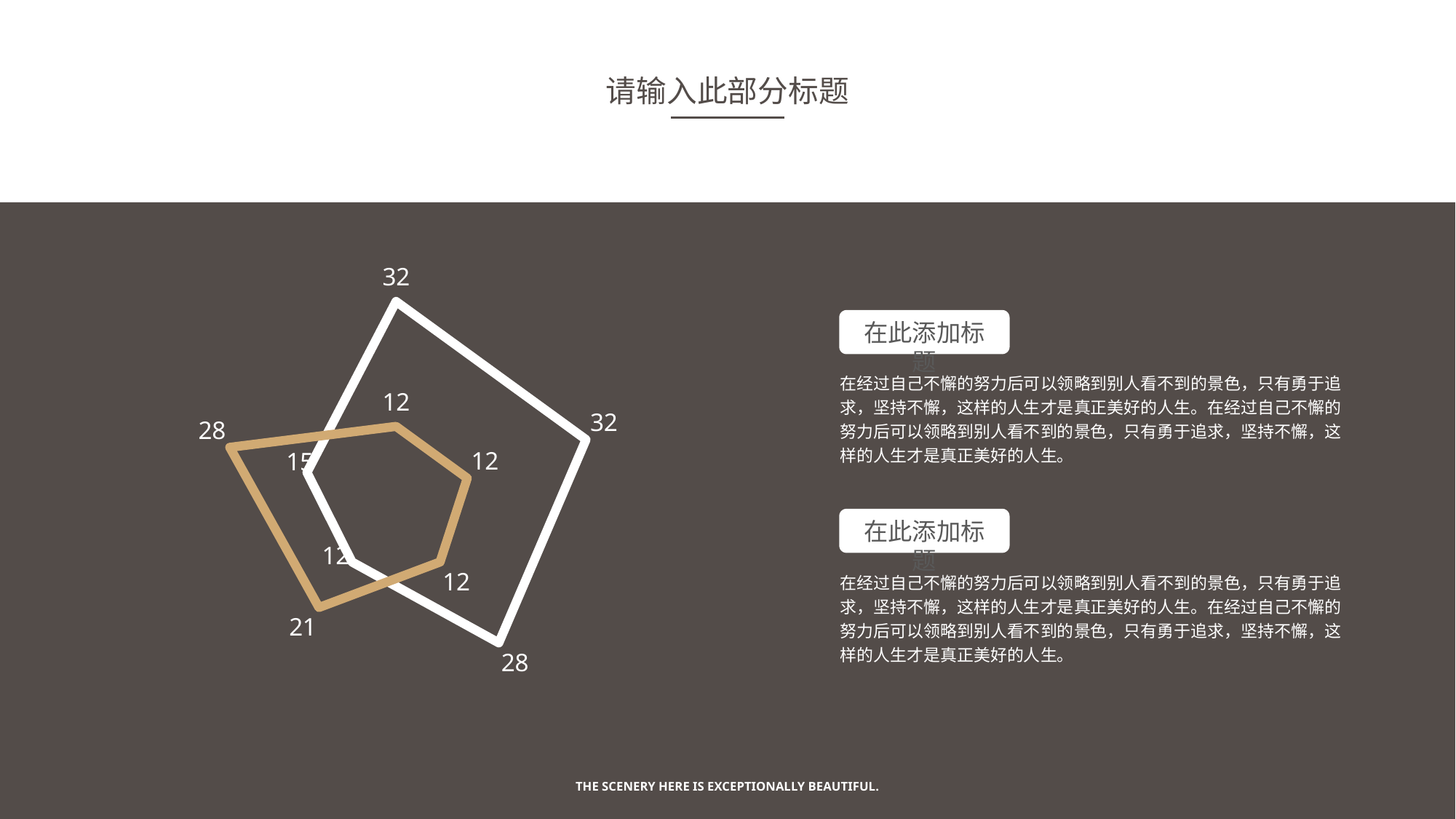
What is the value of the tan series at the bottom-left vertex of the radar chart? 21 What is the value of the tan series at the top vertex of the radar chart? 12 How many series are plotted in the radar chart? 2 What is the lowest value in the white series? 12 At the top vertex, what is the difference between the white series value and the tan series value? 20 What kind of chart is shown on the slide? Radar chart What is the value of the white series at the top vertex of the radar chart? 32 How many data points (axes) does each series in the radar chart have? 5 What is the value of the white series at the bottom-right vertex of the radar chart? 28 What is the highest value in the tan series? 28 At the left vertex, which series has the larger value, white or tan? Tan What is the value of the tan series at the left vertex of the radar chart? 28